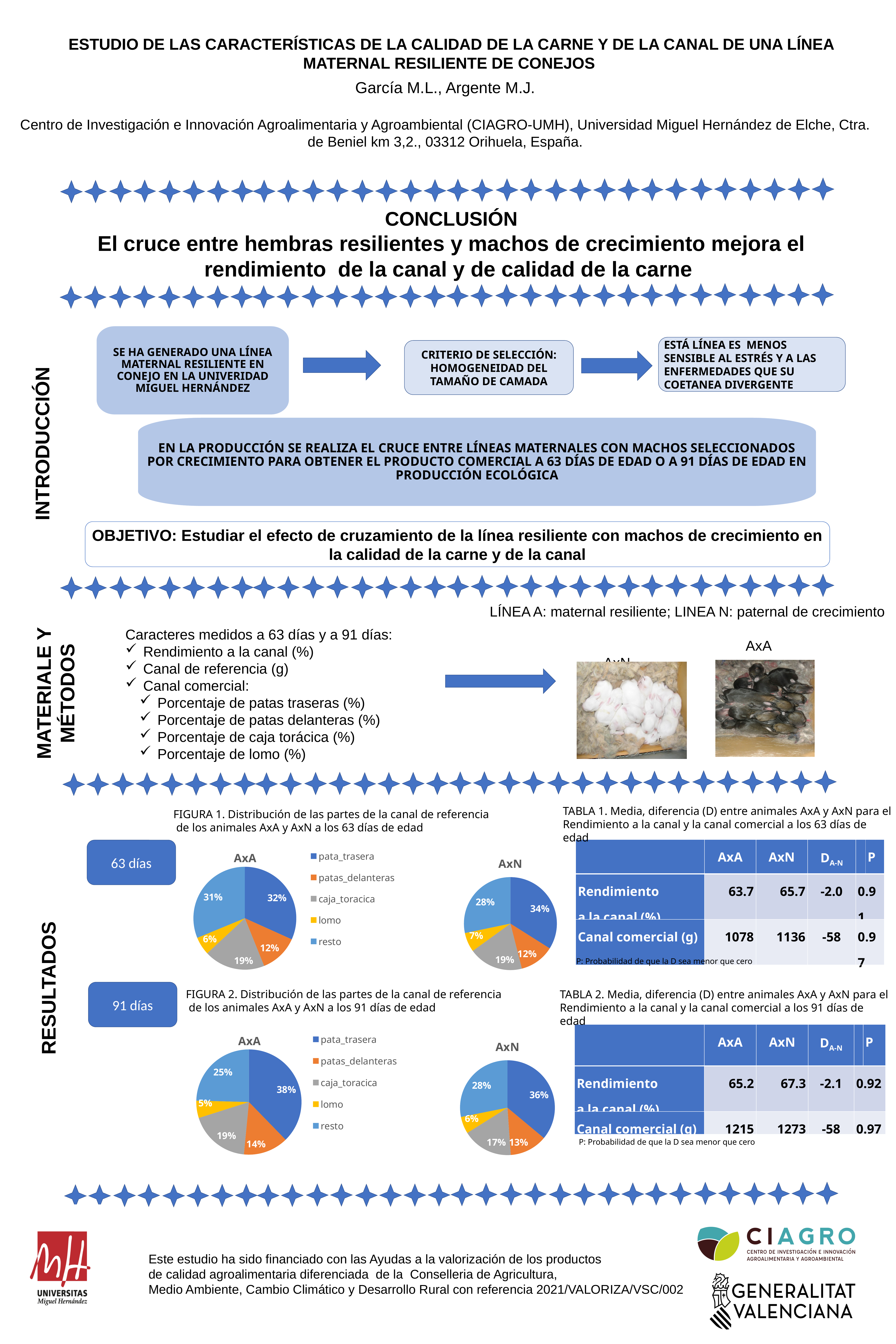
How many entries does the legend of Figura 2 (91 días) list? 5 In the legend of Figura 1, which part is shown in orange? patas_delanteras In the AxA pie chart of Figura 2 (91 días), which part has the largest share? pata_trasera In the AxN pie chart of Figura 2 (91 días), what share is caja_toracica? 17% In the AxA pie chart of Figura 1 (63 días), which part has the smallest share? lomo In the AxA pie chart of Figura 1 (63 días), what share is pata_trasera? 32% How many slices does the AxN pie chart of Figura 1 (63 días) have? 5 In Figura 2 (91 días), which is larger: the pata_trasera share for AxA or for AxN? AxA In the AxN pie chart of Figura 1 (63 días), what share is resto? 28% What type of chart is used in Figura 1 for the AxA and AxN distributions? Pie chart In the AxA pie chart of Figura 2 (91 días), what share is lomo? 5% In the AxN pie chart of Figura 1 (63 días), what is the difference between the pata_trasera share and the resto share? 6%